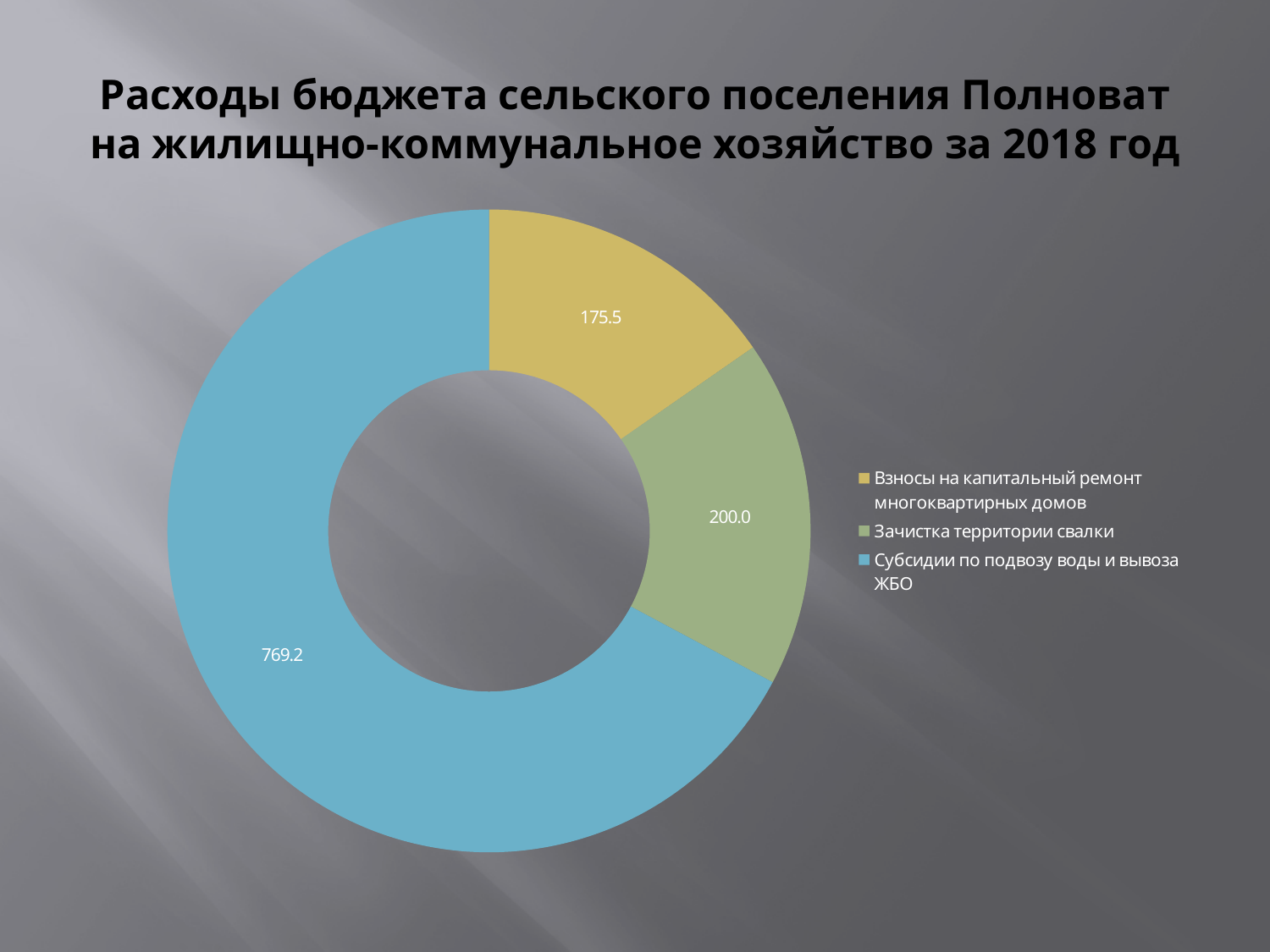
What value is shown for Зачистка территории свалки? 200.0 What colour is the segment for Субсидии по подвозу воды и вывоза ЖБО? Blue Which is larger: Зачистка территории свалки or Взносы на капитальный ремонт многоквартирных домов? Зачистка территории свалки What is the difference between the values for Субсидии по подвозу воды и вывоза ЖБО and Зачистка территории свалки? 569.2 Which category has the smallest value? Взносы на капитальный ремонт многоквартирных домов What is the difference between the values for Зачистка территории свалки and Взносы на капитальный ремонт многоквартирных домов? 24.5 What value is shown for Субсидии по подвозу воды и вывоза ЖБО? 769.2 What kind of chart is shown on the slide? Doughnut chart What value is shown for Взносы на капитальный ремонт многоквартирных домов? 175.5 Which category has the largest value? Субсидии по подвозу воды и вывоза ЖБО How many categories does the chart show? 3 What is the total of all values shown in the chart? 1144.7